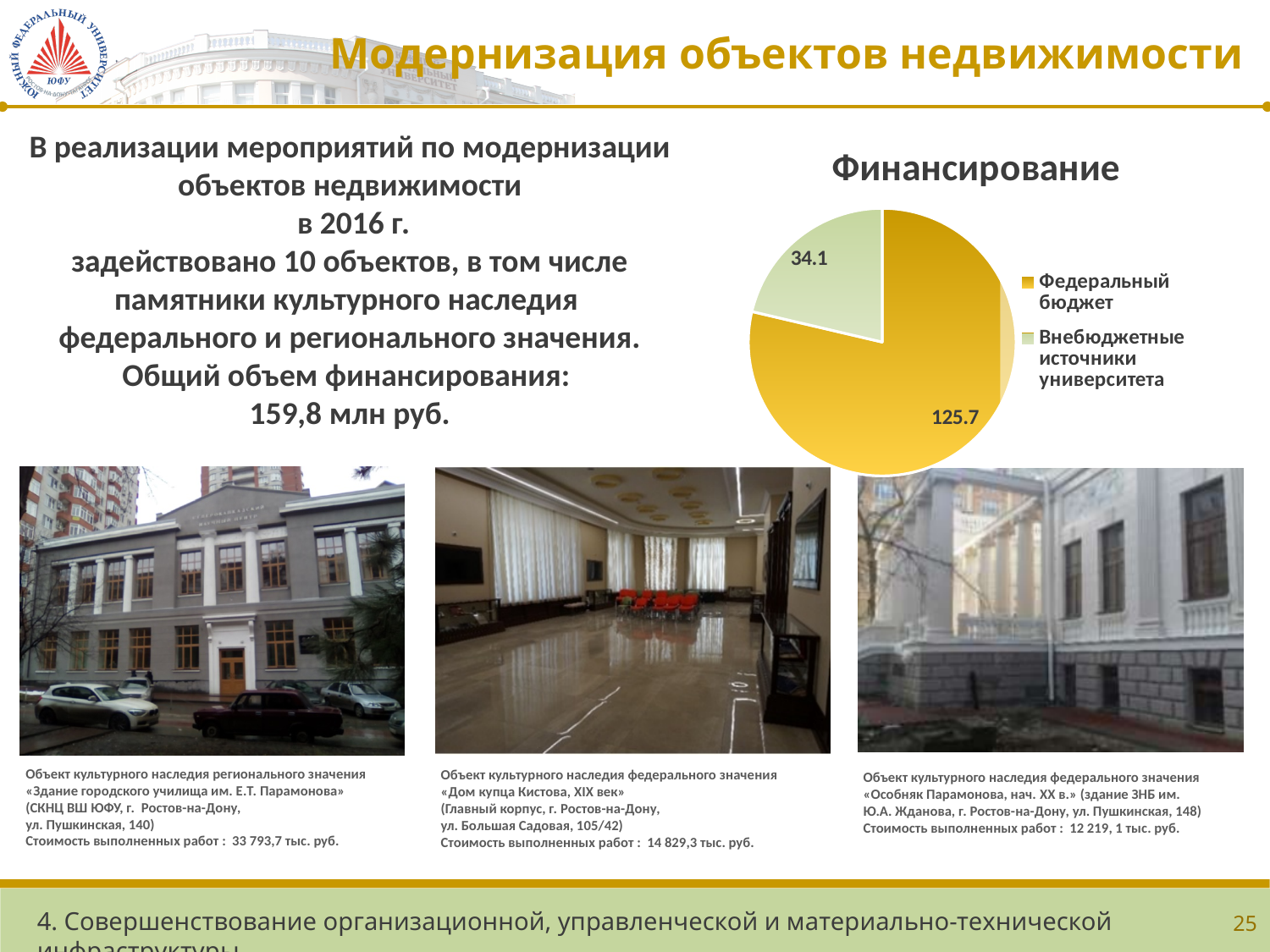
What type of chart is shown under the title «Финансирование»? pie chart What share of the «Финансирование» pie chart does «Федеральный бюджет» represent? 78.7% What is the value for «Федеральный бюджет» in the «Финансирование» pie chart? 125.7 What is the title of the pie chart on the slide? Финансирование How many entries does the legend of the «Финансирование» pie chart list? 2 What is the value for «Внебюджетные источники университета» in the «Финансирование» pie chart? 34.1 What is the total of the two values shown in the «Финансирование» pie chart? 159.8 In the «Финансирование» pie chart, which is larger: «Федеральный бюджет» or «Внебюджетные источники университета»? Федеральный бюджет Which slice of the «Финансирование» pie chart is the largest? Федеральный бюджет In the «Финансирование» pie chart, what is the difference between the value for «Федеральный бюджет» and the value for «Внебюджетные источники университета»? 91.6 How many slices does the «Финансирование» pie chart have? 2 Which slice of the «Финансирование» pie chart is the smallest? Внебюджетные источники университета